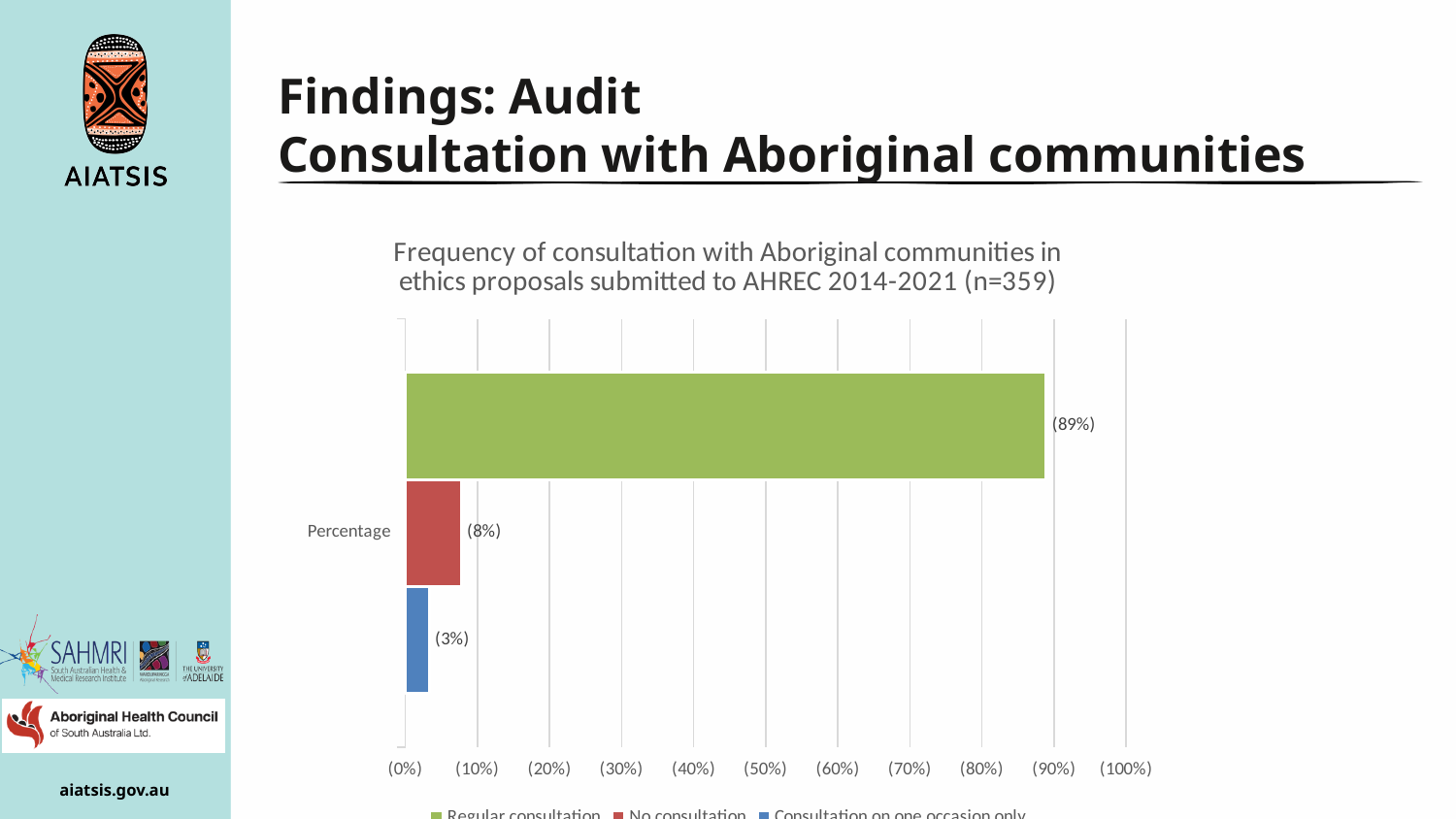
What kind of chart is shown on the slide? Bar chart Is the value for Regular consultation greater or less than 80%? greater What is the value for No consultation? (8%) What is the value for Regular consultation? (89%) What is the difference between the values for Regular consultation and No consultation? 81 percentage points What is the title of the chart? Frequency of consultation with Aboriginal communities in ethics proposals submitted to AHREC 2014-2021 (n=359) Which series has the highest value? Regular consultation Which is larger, the value for No consultation or the value for Consultation on one occasion only? No consultation How many series does the legend list? 3 Which series has the lowest value? Consultation on one occasion only What is the value for Consultation on one occasion only? (3%) What colour is the bar for No consultation? Red